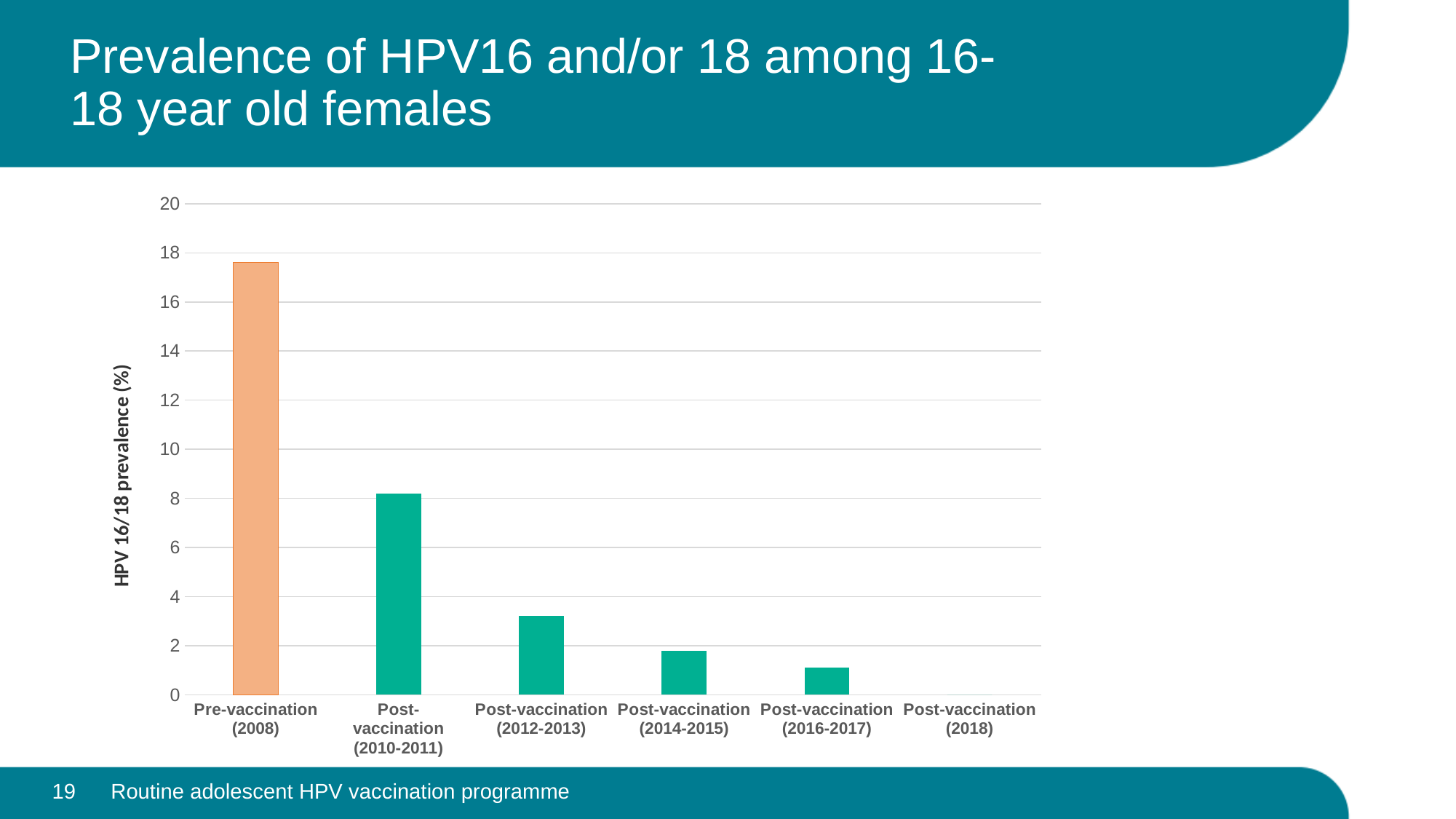
How many categories (bars) are shown in the chart? 6 What is the label on the vertical axis of the chart? HPV 16/18 prevalence (%) Which is larger, the value for Post-vaccination (2010-2011) or Post-vaccination (2014-2015)? Post-vaccination (2010-2011) Is the value for Post-vaccination (2012-2013) greater or less than 4? less Which category has the highest HPV 16/18 prevalence? Pre-vaccination (2008) Which category has the lowest HPV 16/18 prevalence? Post-vaccination (2018) Which bar is coloured differently (orange) from the other bars? Pre-vaccination (2008) What type of chart is shown on the slide? Bar chart Is the value for Post-vaccination (2010-2011) greater or less than 10? less Is the value for Pre-vaccination (2008) greater or less than 16? greater Do the values rise or fall moving from left to right along the x axis? Fall